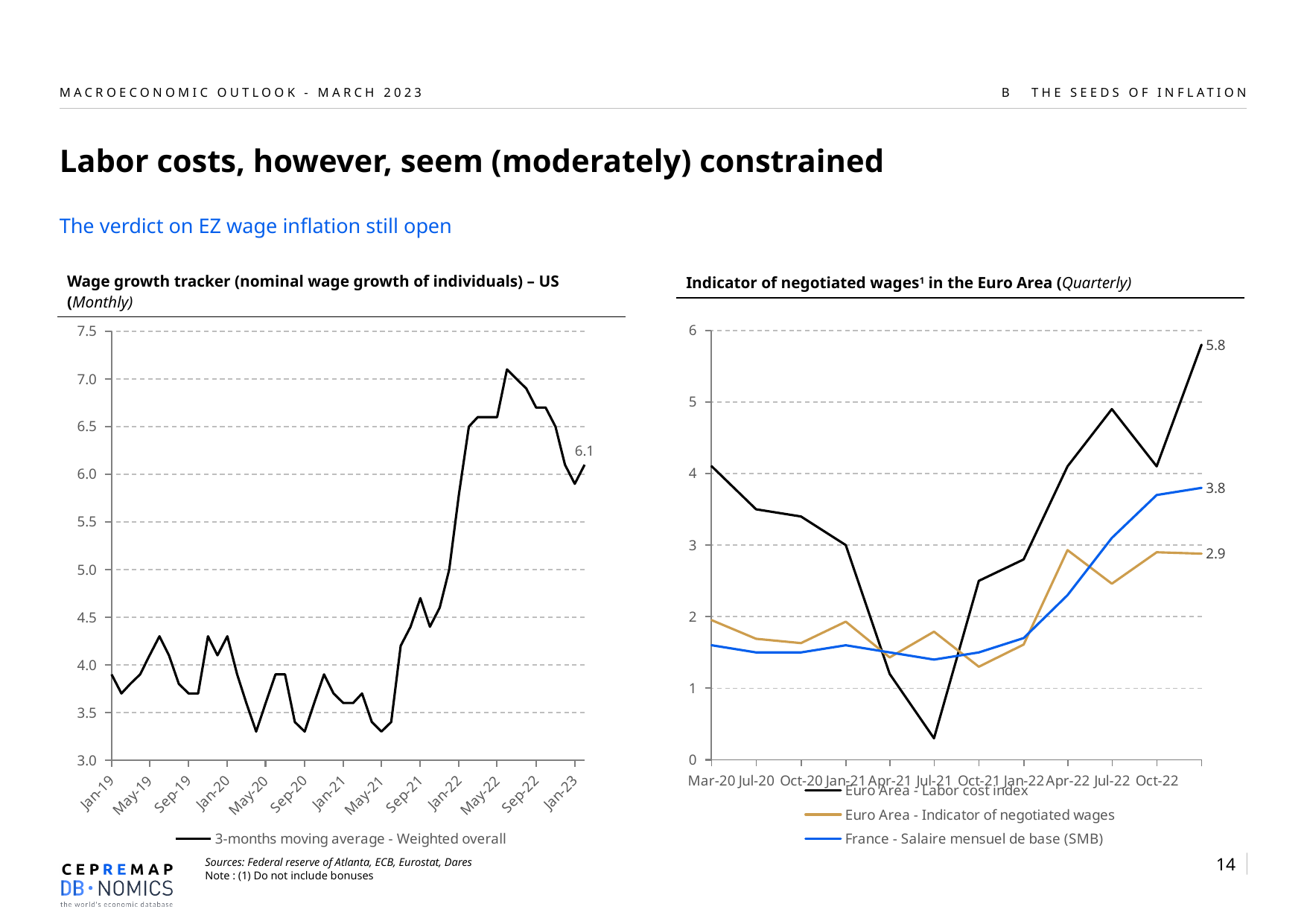
How many series does the legend of the right chart (Indicator of negotiated wages in the Euro Area) list? 3 On the right chart (Euro Area), what colour is the line for 'France - Salaire mensuel de base (SMB)'? Blue On the right chart (Euro Area), which series has the lowest value at the end of the period? Euro Area - Indicator of negotiated wages On the right chart (Euro Area), what is the last printed value for 'Euro Area - Labor cost index'? 5.8 On the left chart (US wage growth tracker), what is the value printed at the end of the line, at Jan-23? 6.1 What kind of chart is the left chart, 'Wage growth tracker (nominal wage growth of individuals) – US'? Line chart On the right chart (Euro Area), what is the difference between the final labelled values of the Labor cost index (5.8) and the Indicator of negotiated wages (2.9)? 2.9 On the left chart (US wage growth tracker), does the line rise or fall between Sep-21 and May-22? Rises How many series does the legend of the left chart (US wage growth tracker) list? 1 On the right chart (Euro Area), is the value of 'Euro Area - Labor cost index' at Jul-21 greater or less than 1? less On the left chart (US wage growth tracker), is the value at May-21 greater or less than 3.5? less On the right chart (Euro Area), what is the last printed value for 'France - Salaire mensuel de base (SMB)'? 3.8